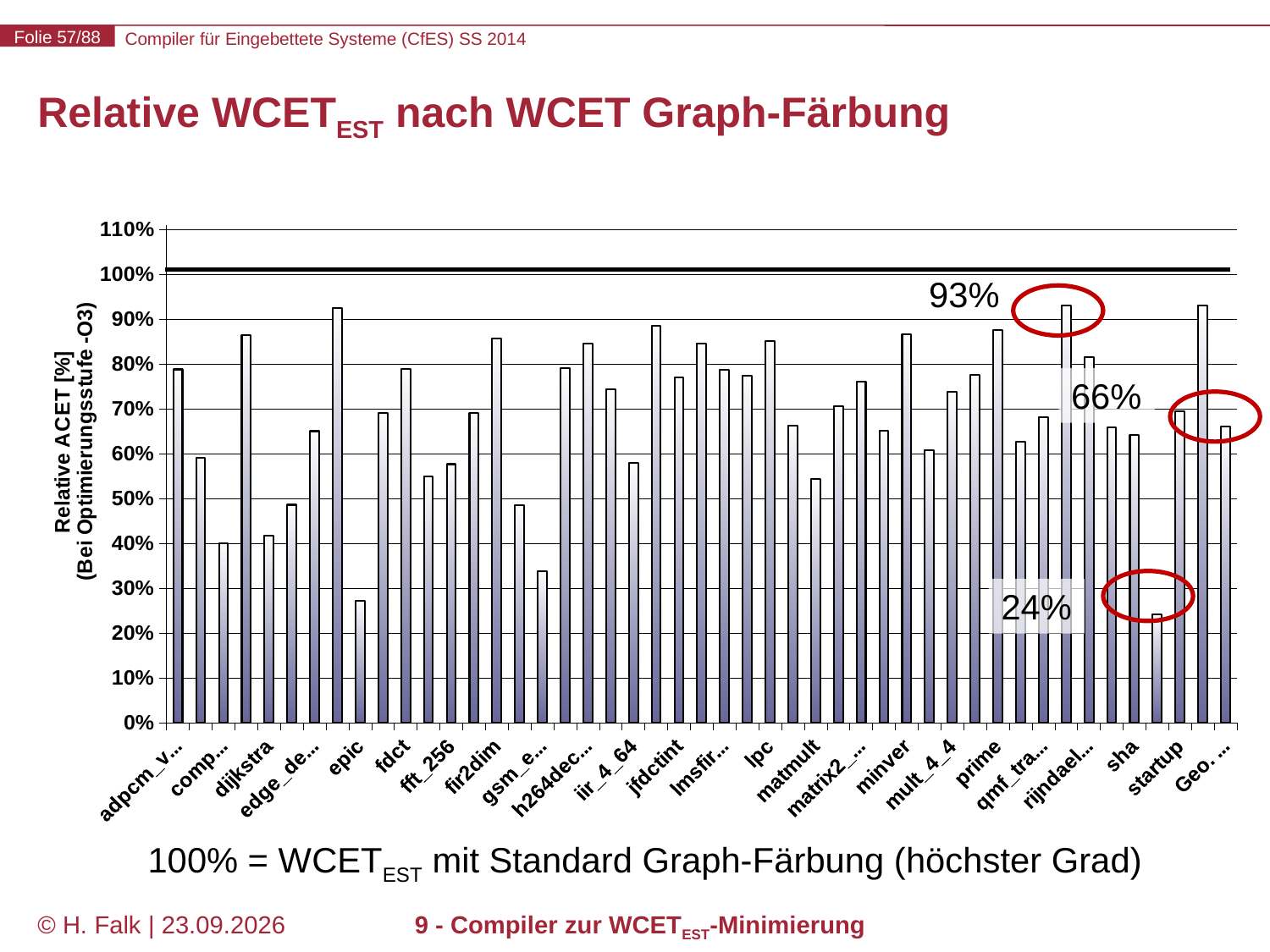
What value does the thick horizontal reference line mark on the y-axis? 100% Is the value for lpc greater or less than 80%? greater What kind of chart is shown on the slide? bar chart Is the value for epic greater or less than 30%? less Do any bars rise above the 100% reference line? No What is the annotated value for the circled last bar (Geo. mean)? 66% What is the title of the chart's y-axis? Relative ACET [%] (Bei Optimierungsstufe -O3) What is the lowest value annotated with a circle on the chart? 24% What is the difference between the annotated values 93% and 24%? 69% What is the highest value annotated with a circle on the chart? 93%